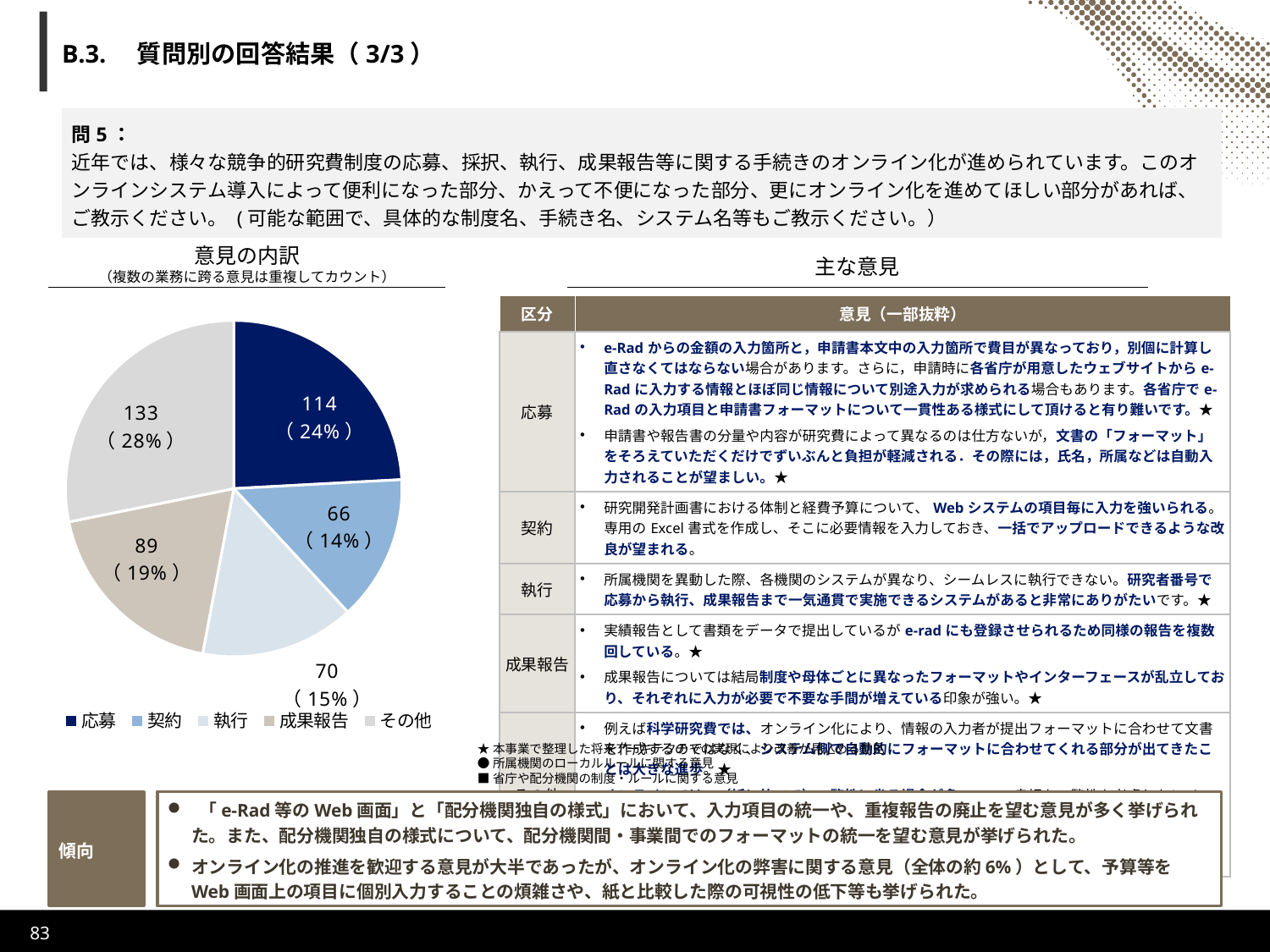
In the pie chart 意見の内訳, what is the value for 成果報告? 89 In the pie chart 意見の内訳, which category has the largest value? その他 In the pie chart 意見の内訳, what percentage share is shown for その他? 28% In the pie chart 意見の内訳, what is the difference between the values for その他 and 応募? 19 In the pie chart 意見の内訳, what is the value for 執行? 70 What type of chart is shown under the title 意見の内訳? pie chart In the pie chart 意見の内訳, which category has the smallest value? 契約 In the pie chart 意見の内訳, what is the total of all five category values? 472 In the pie chart 意見の内訳, what percentage share is shown for 契約? 14% In the pie chart 意見の内訳, what is the value for 応募? 114 How many categories does the pie chart 意見の内訳 show? 5 In the pie chart 意見の内訳, which is larger, the value for 成果報告 or the value for 執行? 成果報告